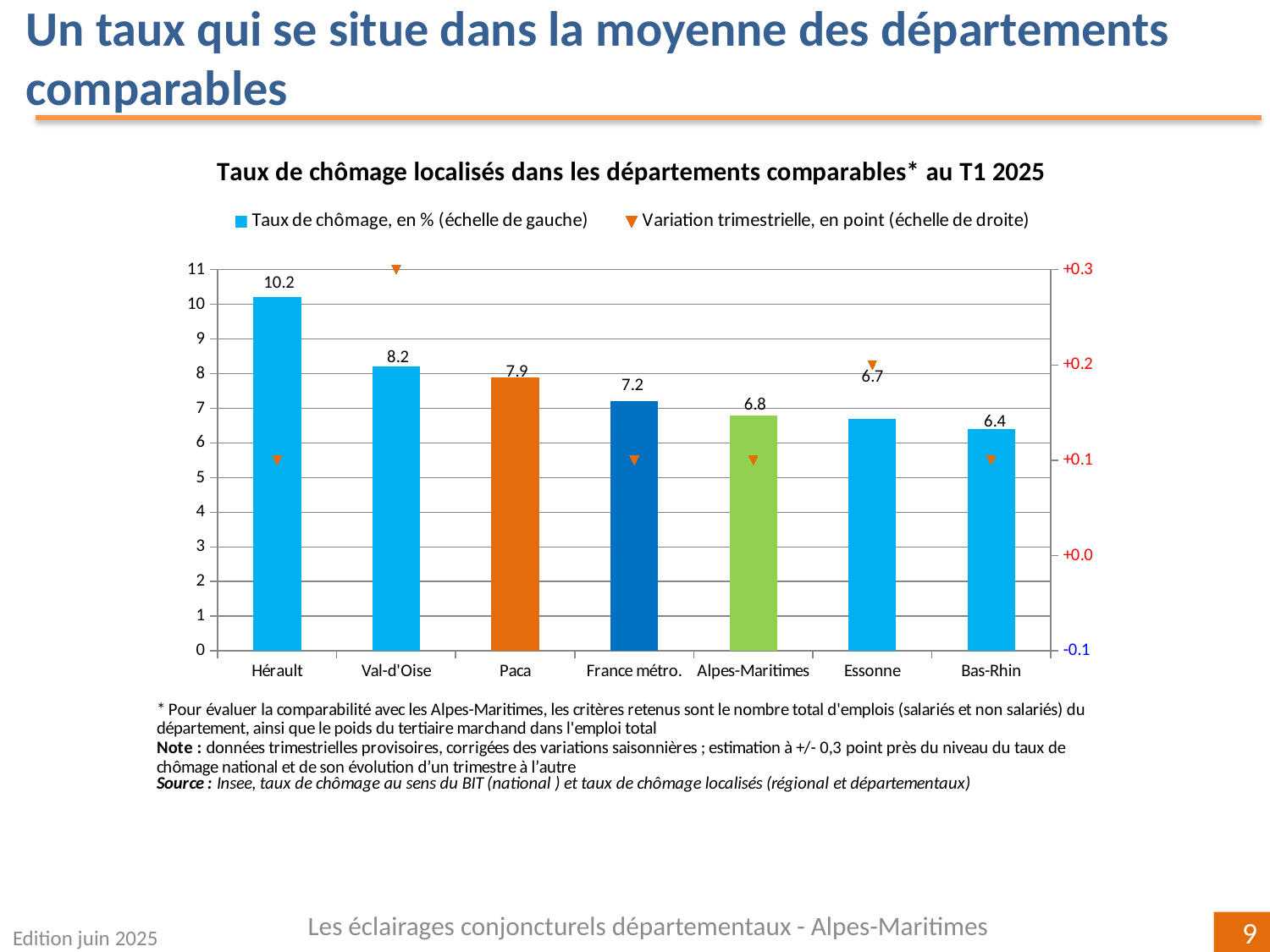
Which has a higher unemployment rate, Paca or Essonne? Paca What is the unemployment rate shown for France métro.? 7.2 What is the quarterly variation (Variation trimestrielle) marker value for Val-d'Oise on the right axis? +0.3 Which category has the highest unemployment rate? Hérault How many categories are shown on the x axis? 7 What is the unemployment rate (Taux de chômage) for Hérault? 10.2 What is the unemployment rate shown for Alpes-Maritimes? 6.8 What is the difference between the unemployment rates of Val-d'Oise and Paca? 0.3 How many series does the legend list? 2 What is the difference between the unemployment rates of Hérault and Bas-Rhin? 3.8 Which category has the lowest unemployment rate? Bas-Rhin What kind of chart is used to show the unemployment rates? Bar chart